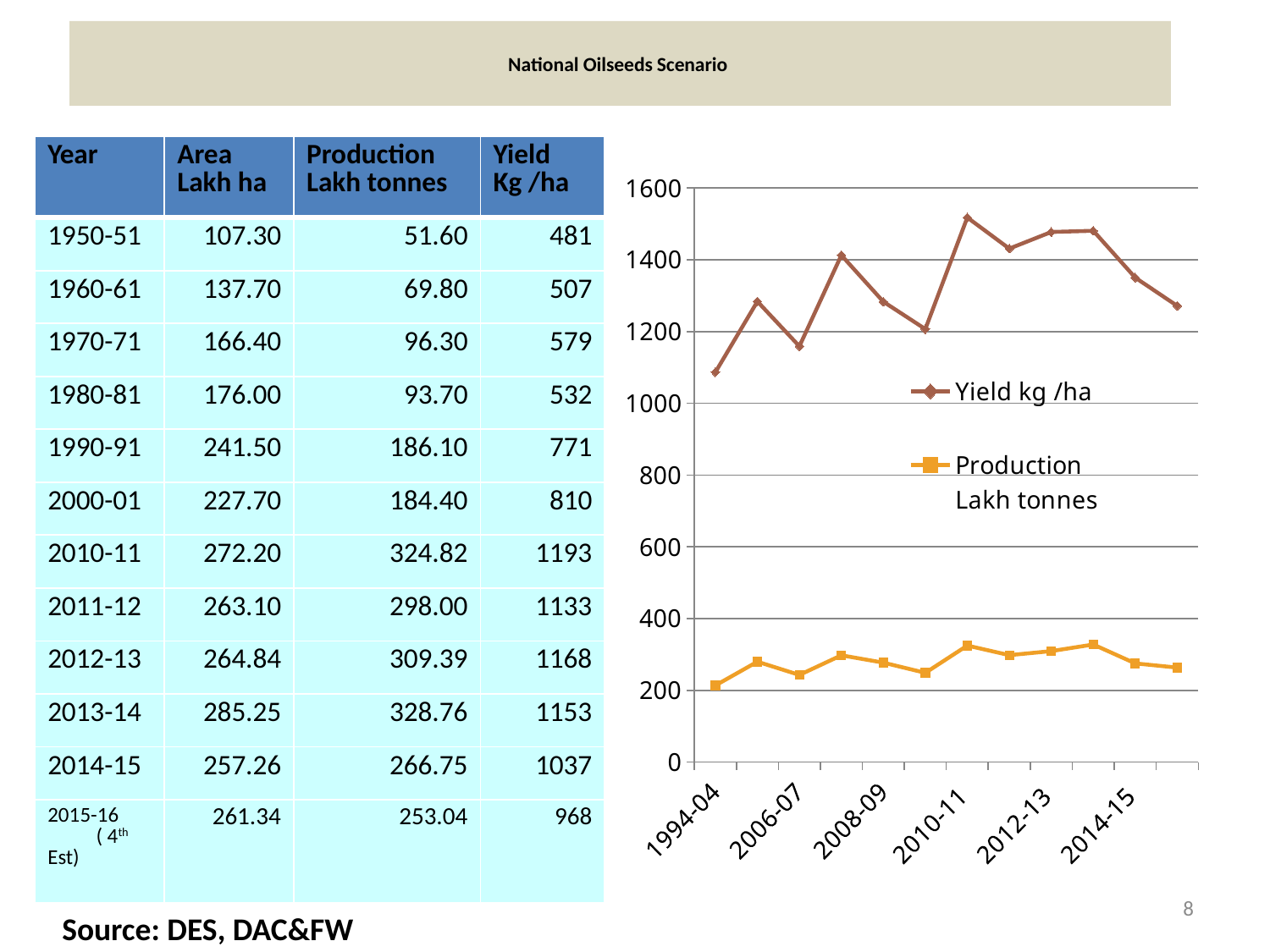
How many series does the chart legend list? 2 What are the two series named in the chart legend? Yield kg /ha and Production Lakh tonnes Does the Yield kg /ha line rise or fall from 2012-13 to the last point on the chart? Fall What kind of chart is shown on the slide? Line chart Is the Production Lakh tonnes value for 2010-11 in the chart greater or less than 400? less At which x-axis label does the Yield kg /ha line reach its highest point? 2010-11 At which x-axis label is the Yield kg /ha line at its lowest point? 1994-04 Is the Yield kg /ha value for 1994-04 in the chart greater or less than 1200? less Which series has the higher values throughout the chart, Yield kg /ha or Production Lakh tonnes? Yield kg /ha Is the Yield kg /ha value for 2010-11 in the chart greater or less than 1400? greater How many data points does each line in the chart have? 12